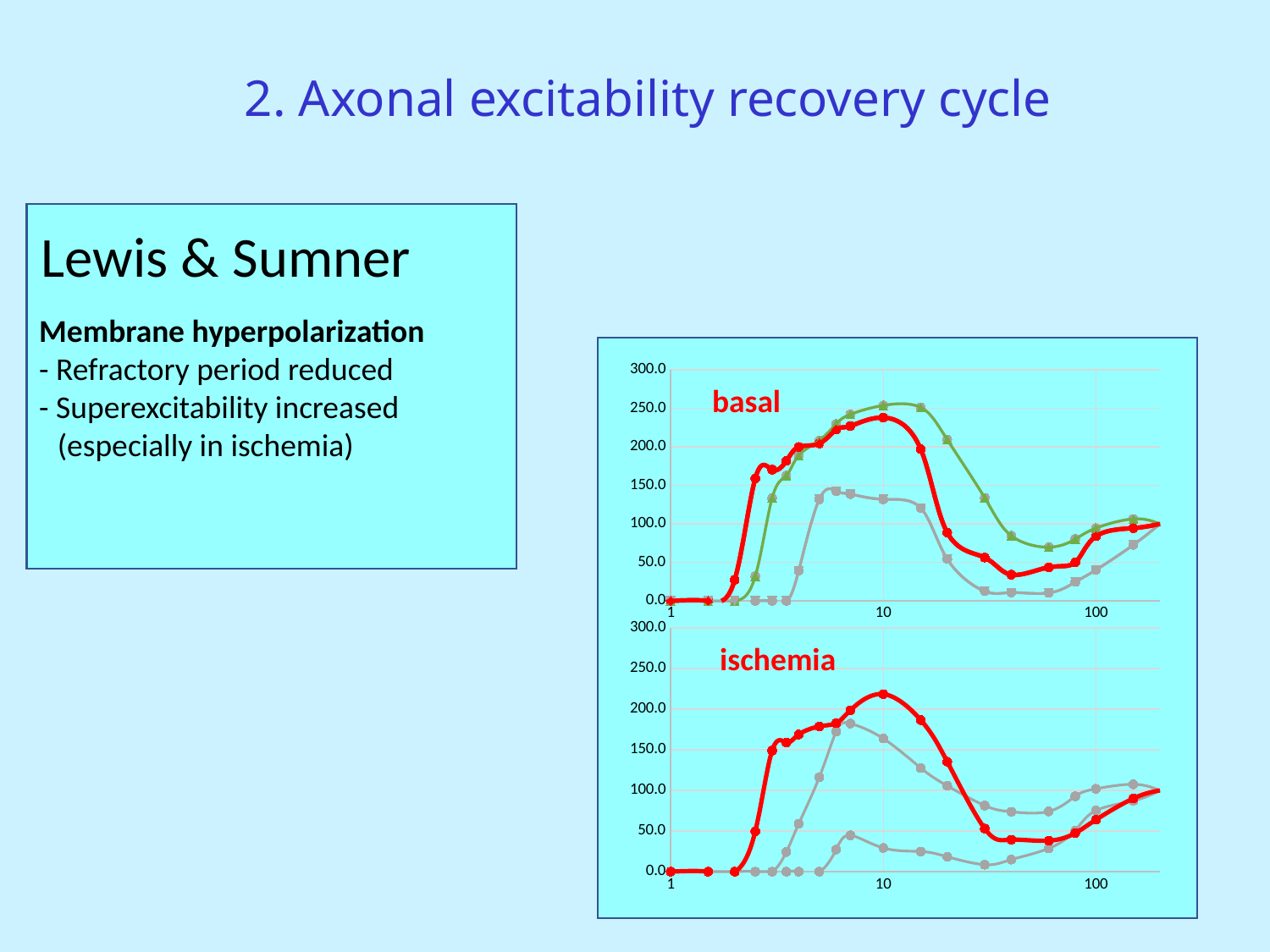
How many charts are shown on the slide? 2 What are the titles of the two charts on the slide? basal and ischemia In the 'ischemia' chart, does the red line rise or fall between x = 2 and x = 10? rise In the 'basal' chart, which line reaches a higher peak, the red line or the grey line? red line In the 'ischemia' chart, is the peak value of the lower grey line greater or less than 100? less In the 'basal' chart, is the peak value of the red line greater or less than 200? greater In the 'basal' chart, is the peak value of the grey line greater or less than 100? greater In the 'basal' chart, does the red line rise or fall between x = 10 and x = 40? fall In the 'basal' chart, at x = 30, which line is higher, the green line or the red line? green line What is the highest value shown on the y axis of the 'ischemia' chart? 300.0 What kind of chart is the 'basal' chart? line chart